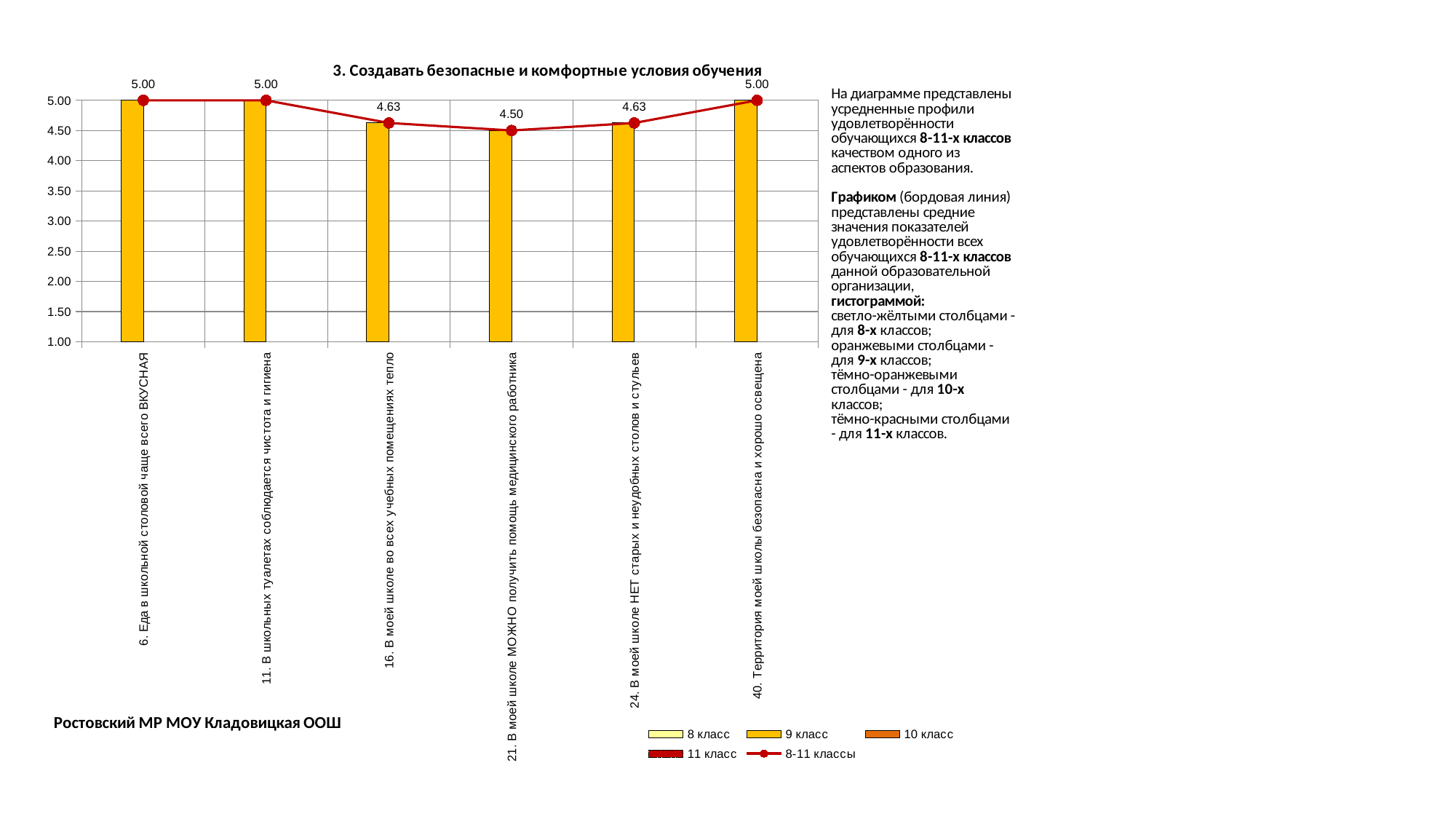
What is the difference between the value for "11. В школьных туалетах соблюдается чистота и гигиена" and the value for "21. В моей школе МОЖНО получить помощь медицинского работника"? 0.50 What value is shown for category "16. В моей школе во всех учебных помещениях тепло"? 4.63 What value is shown for category "6. Еда в школьной столовой чаще всего ВКУСНАЯ"? 5.00 What value is shown for category "21. В моей школе МОЖНО получить помощь медицинского работника"? 4.50 Which is larger: the value for "40. Территория моей школы безопасна и хорошо освещена" or the value for "16. В моей школе во всех учебных помещениях тепло"? 40. Территория моей школы безопасна и хорошо освещена How many series does the chart legend list? 5 What is the title of the chart? 3. Создавать безопасные и комфортные условия обучения What kind of chart is shown on the slide? Combined bar and line chart Which category has the lowest value on the chart? 21. В моей школе МОЖНО получить помощь медицинского работника What is the difference between the value for "24. В моей школе НЕТ старых и неудобных столов и стульев" and the value for "21. В моей школе МОЖНО получить помощь медицинского работника"? 0.13 How many categories are shown on the x axis of the chart? 6 Is the value for "21. В моей школе МОЖНО получить помощь медицинского работника" greater or less than 4.00? greater